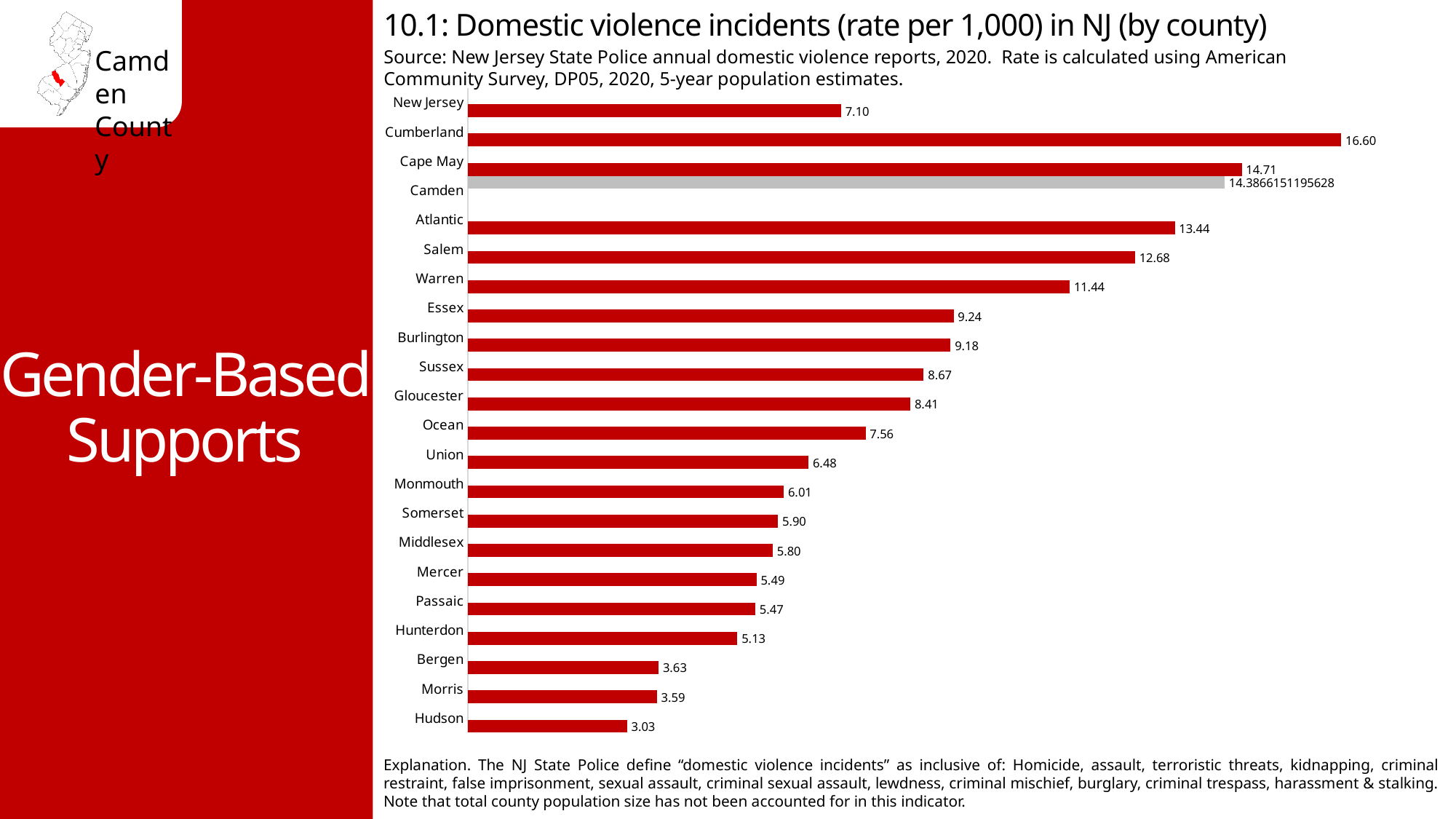
How many bars are plotted in the chart? 22 Which has a higher domestic violence incident rate, Bergen or Morris? Bergen What is the domestic violence incident rate per 1,000 for New Jersey overall? 7.10 Which county has the lowest domestic violence incident rate? Hudson Which bar is shown in grey rather than red? Camden What type of chart is shown on the slide? Bar chart What is the domestic violence incident rate per 1,000 for Camden County? 14.3866151195628 What is the difference between the rates for Cumberland and Hudson? 13.57 Which has a higher domestic violence incident rate, Salem or Warren? Salem What is the domestic violence incident rate per 1,000 for Gloucester County? 8.41 Which county has the highest domestic violence incident rate? Cumberland What is the difference between the rates for Cape May and Atlantic? 1.27